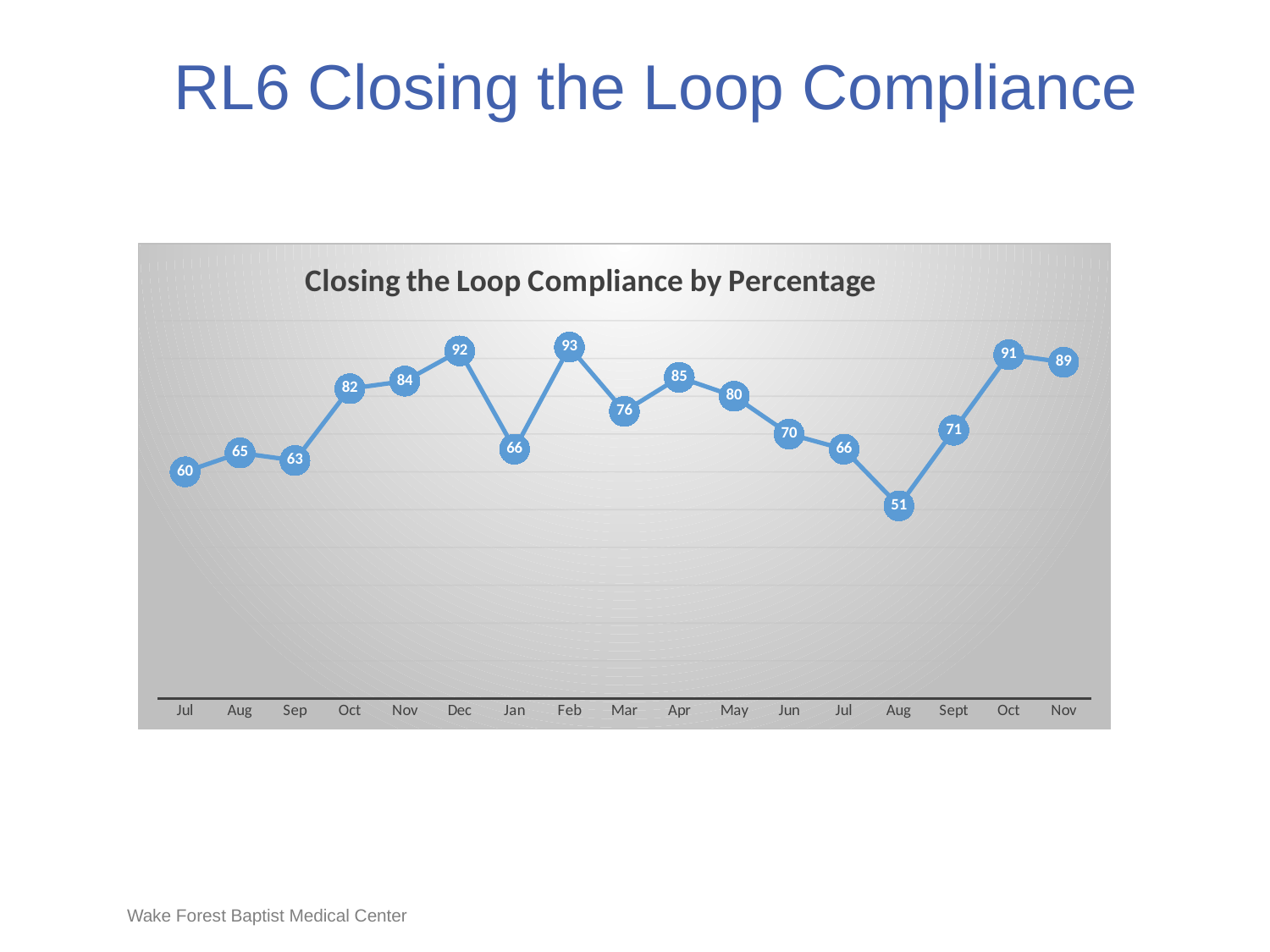
What is the compliance value for Feb? 93 What type of chart is shown on the slide? Line chart Which month has the highest compliance value? Feb What is the compliance value for Mar? 76 What is the title of the chart? Closing the Loop Compliance by Percentage Which is larger, the value for Apr or the value for May? Apr Does the value rise or fall from Sep to Oct (the first Oct)? Rise What is the difference between the values for Feb and Jan? 27 What is the compliance value for Dec? 92 What is the compliance value for the second Aug on the x axis? 51 Which point has the lowest compliance value? The second Aug (51) How many data points are plotted on the chart? 17